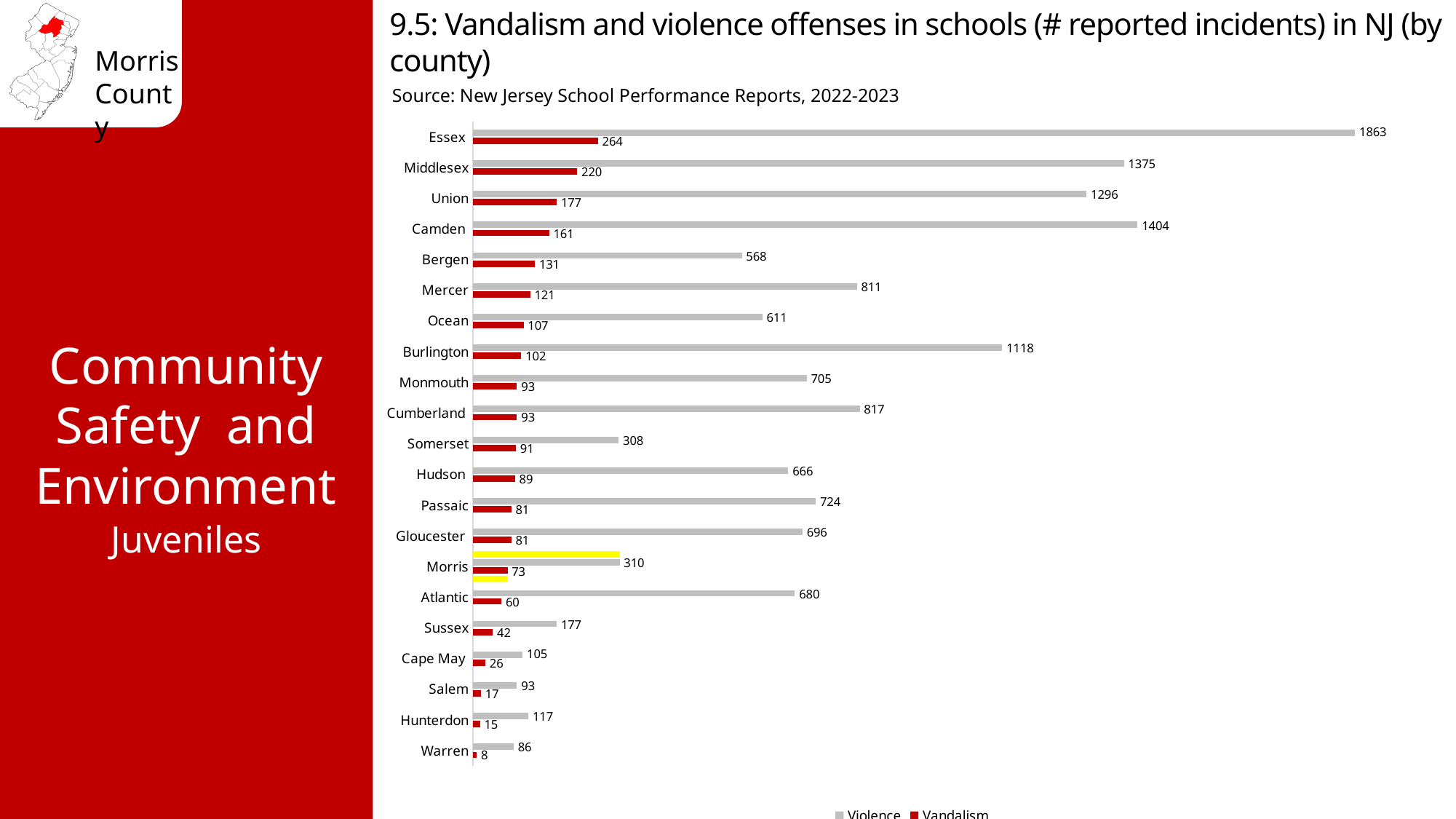
Which county has more reported violence incidents, Camden or Union? Camden How many reported vandalism incidents does the chart show for Morris County? 73 What type of chart is shown on the slide? Bar chart How many series does the legend list? 2 Which county has the lowest number of reported vandalism incidents? Warren What is the difference between the violence values for Essex and Middlesex? 488 How many counties are shown on the chart? 21 Which county has the highest number of reported violence incidents? Essex What is the violence value for Camden? 1404 How many reported violence incidents does the chart show for Morris County? 310 What is the difference between the violence and vandalism values for Bergen? 437 Which series is shown in red on the chart? Vandalism